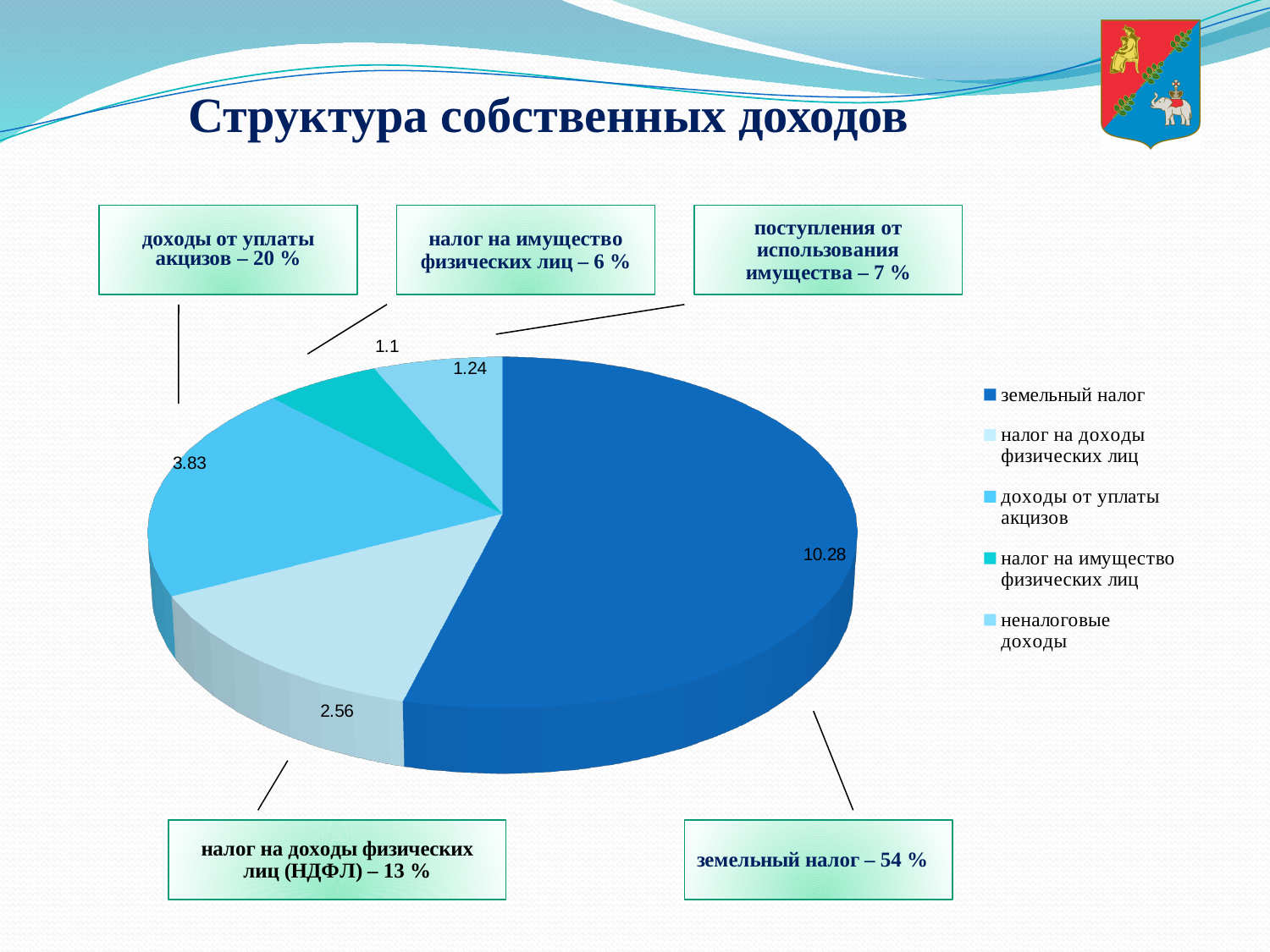
What type of chart is shown on the slide? pie chart Which category has the largest slice of the pie? земельный налог What is the difference between the values for земельный налог and доходы от уплаты акцизов? 6.45 What is the value shown for налог на доходы физических лиц? 2.56 What is the value shown for налог на имущество физических лиц? 1.1 How many slices does the pie chart have? 5 Which category has the smallest slice of the pie? налог на имущество физических лиц Which is larger: доходы от уплаты акцизов or налог на доходы физических лиц? доходы от уплаты акцизов According to the slide, what share of own revenues does земельный налог make up? 54 % What is the value shown for доходы от уплаты акцизов? 3.83 What is the value shown for земельный налог? 10.28 What is the value shown for неналоговые доходы? 1.24